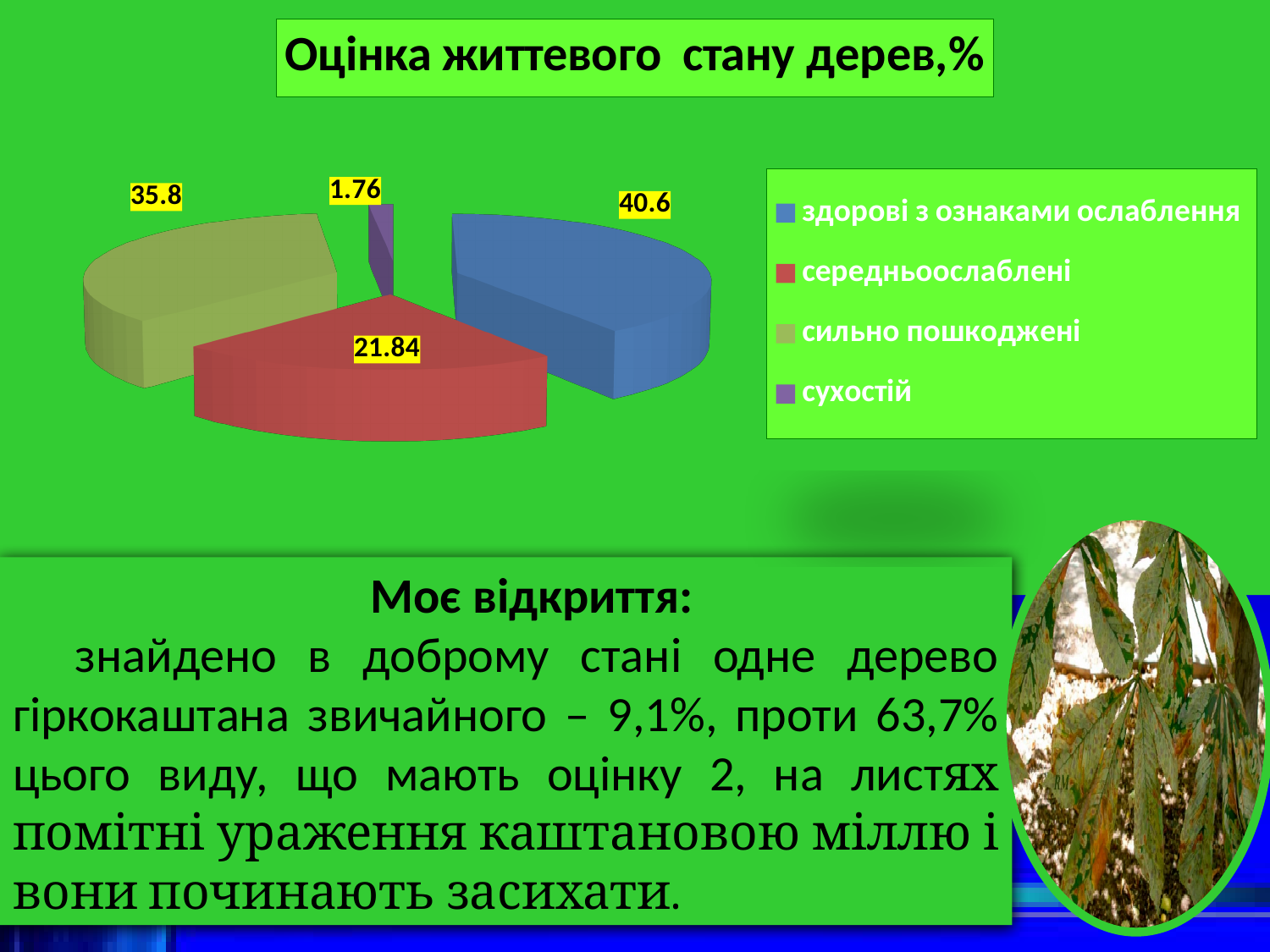
Which is larger, the value for "сильно пошкоджені" or the value for "середньоослаблені"? сильно пошкоджені What is the title of the chart? Оцінка життевого стану дерев,% What colour is the slice for "середньоослаблені"? red What is the difference between the values for "здорові з ознаками ослаблення" and "середньоослаблені"? 18.76 What kind of chart is shown on the slide? pie chart Which category has the largest slice of the pie? здорові з ознаками ослаблення Which category has the smallest slice of the pie? сухостій What is the value for "середньоослаблені"? 21.84 What is the value for "здорові з ознаками ослаблення"? 40.6 What is the value for "сухостій"? 1.76 How many categories does the pie chart show? 4 What is the value for "сильно пошкоджені"? 35.8